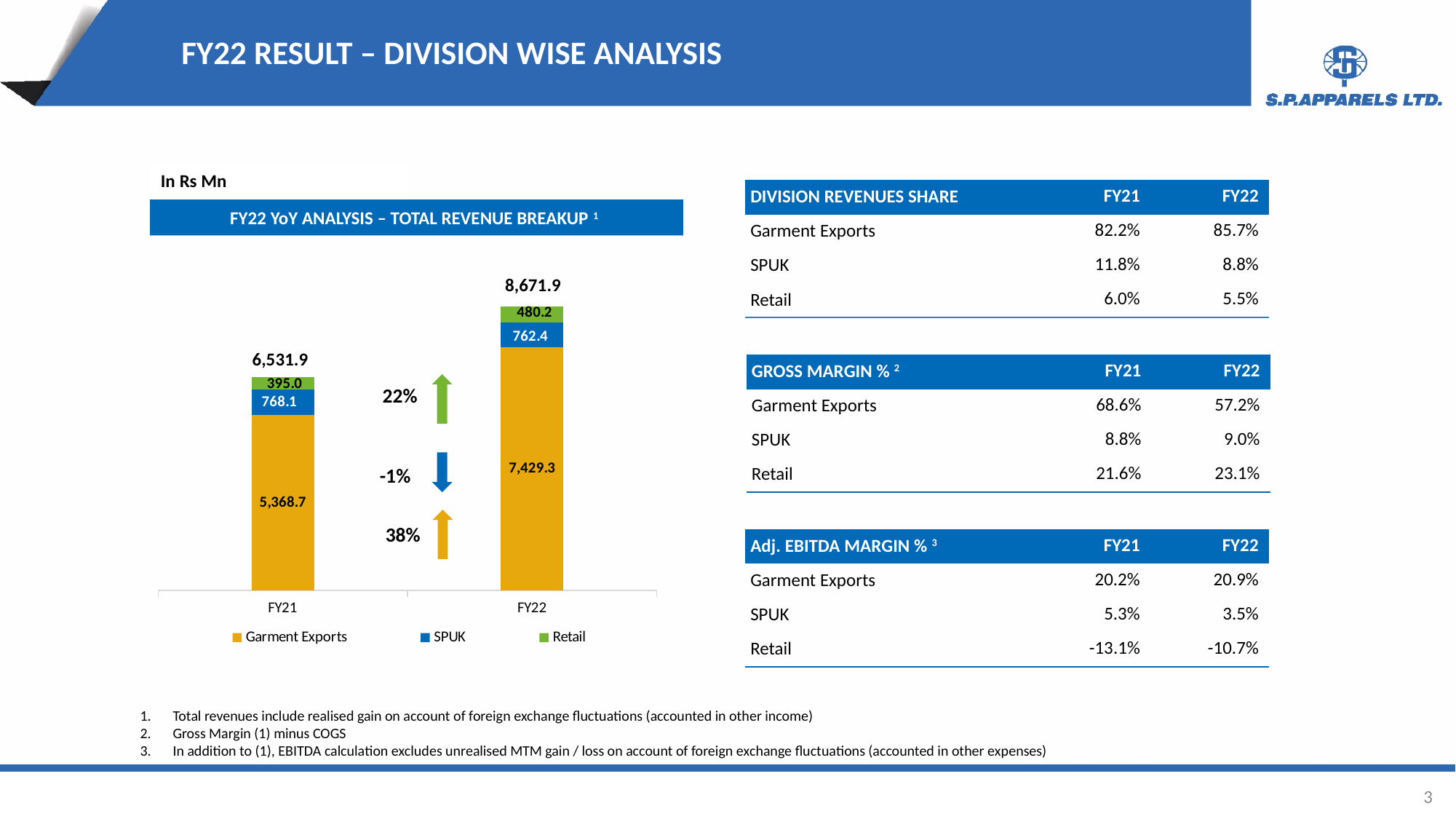
What is the Garment Exports revenue for FY21 in the chart? 5,368.7 What is the total revenue shown above the FY21 bar? 6,531.9 What is the Retail revenue for FY21 in the chart? 395.0 What is the SPUK revenue for FY22 in the chart? 762.4 What type of chart is shown on the slide? Stacked bar chart Which segment is the smallest in the FY21 bar? Retail What is the total revenue shown above the FY22 bar? 8,671.9 What is the difference between Garment Exports revenue in FY22 and FY21? 2,060.6 How many categories (years) are shown on the x axis of the chart? 2 Is the Retail revenue larger in FY21 or FY22? FY22 Which segment is the largest in the FY22 bar? Garment Exports How many series does the chart legend list? 3